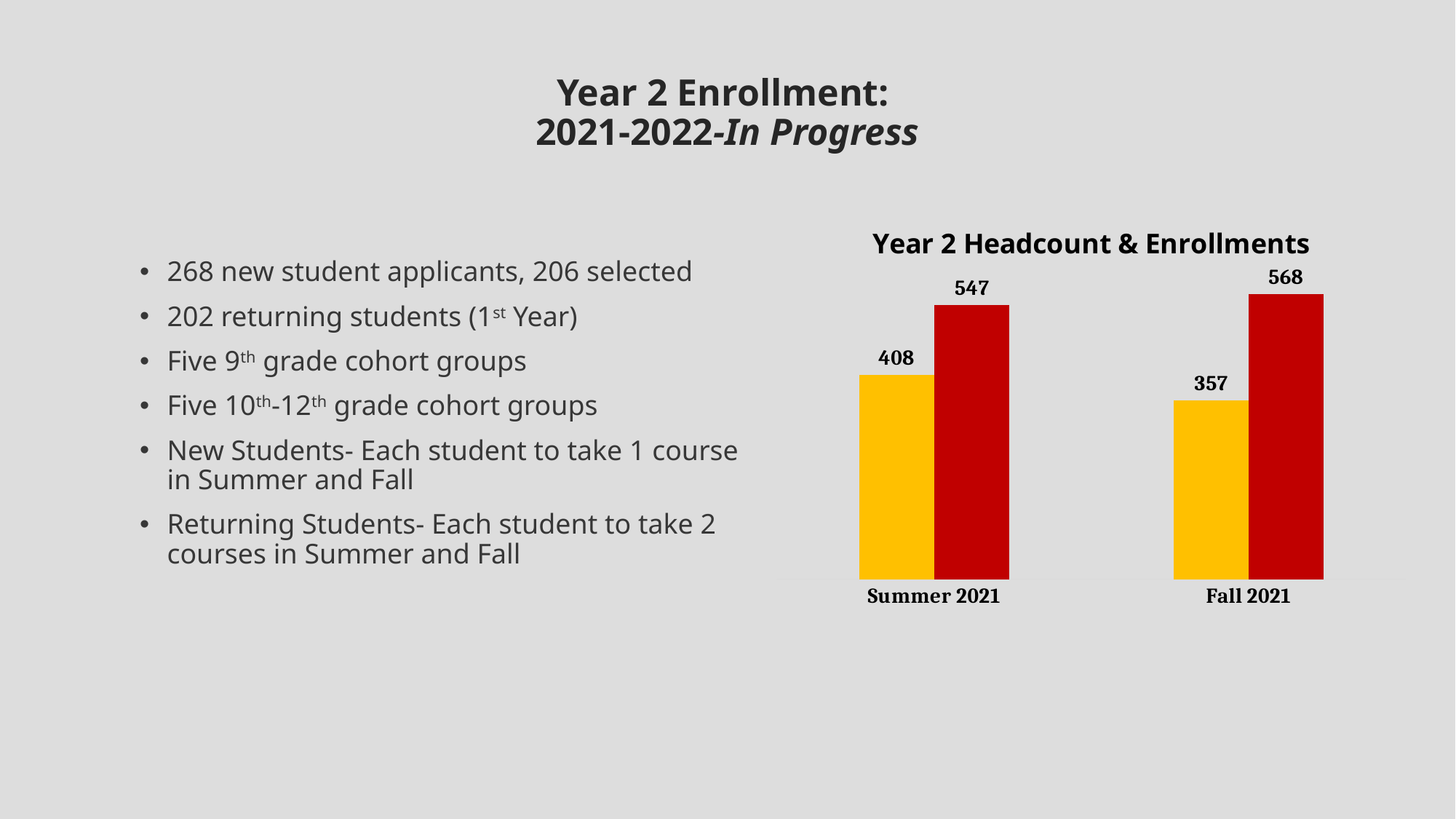
What is the value of the yellow bar for Summer 2021? 408 What is the value of the red bar for Summer 2021? 547 What is the difference between the red and yellow bars for Summer 2021? 139 Which bar in the chart has the highest value? The red bar for Fall 2021 (568) Which is larger, the yellow bar for Summer 2021 or the yellow bar for Fall 2021? Summer 2021 How many categories are shown on the x axis of the chart? 2 Which bar in the chart has the lowest value? The yellow bar for Fall 2021 (357) What kind of chart is shown on the slide? Bar chart What is the difference between the red bar values for Fall 2021 and Summer 2021? 21 What is the value of the red bar for Fall 2021? 568 What is the title of the chart? Year 2 Headcount & Enrollments What is the value of the yellow bar for Fall 2021? 357